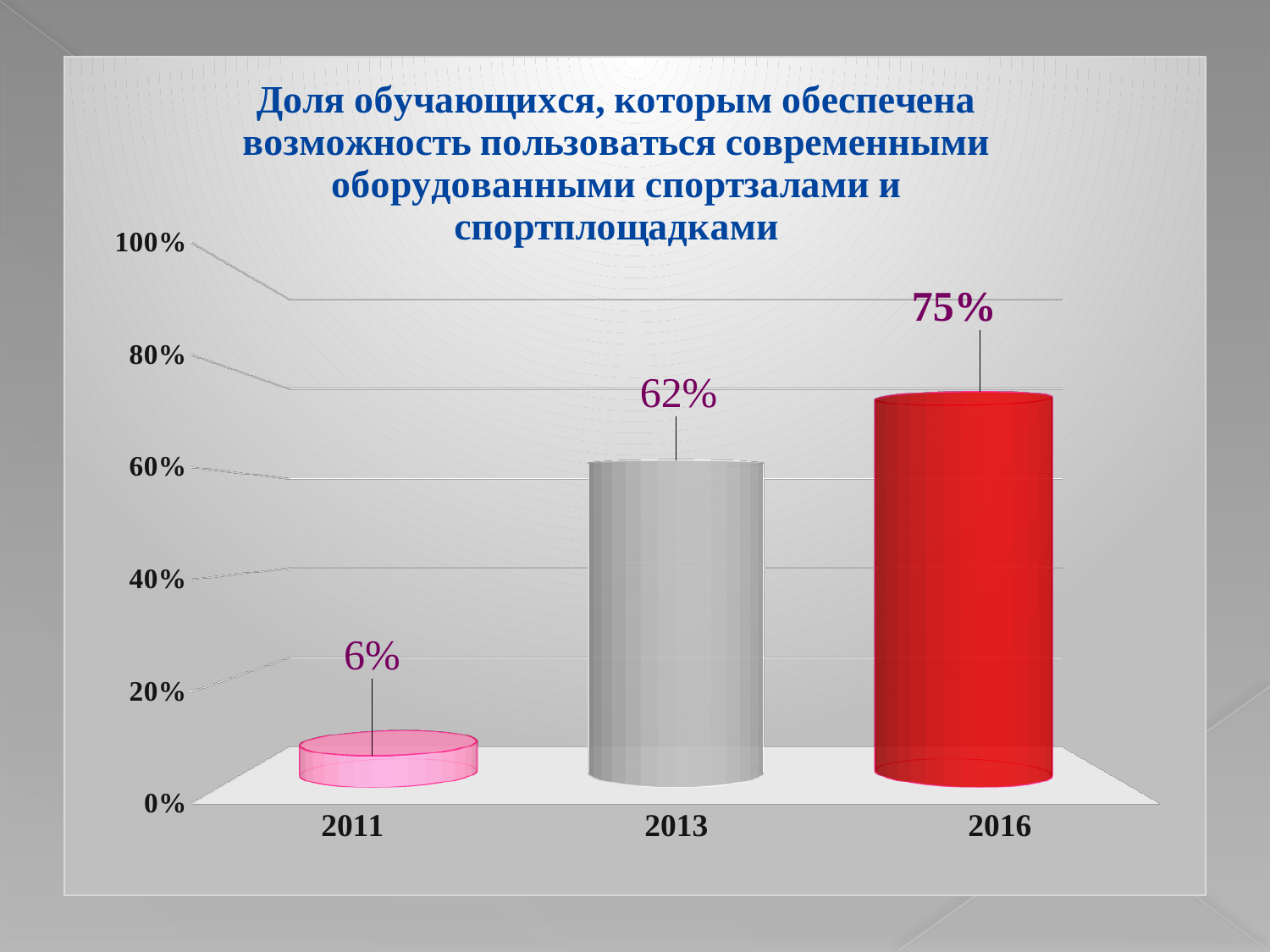
What is the value for 2016? 75% Is the value for 2016 greater or less than 80%? less Which is larger, the value for 2013 or the value for 2016? 2016 What is the value for 2013? 62% What is the difference between the values for 2016 and 2013? 13% Which year has the lowest value? 2011 How many years are shown on the chart? 3 What is the difference between the values for 2013 and 2011? 56% Do the values rise or fall from 2011 to 2016? rise What kind of chart is shown on the slide? bar chart Which year has the highest value? 2016 What is the value for 2011? 6%